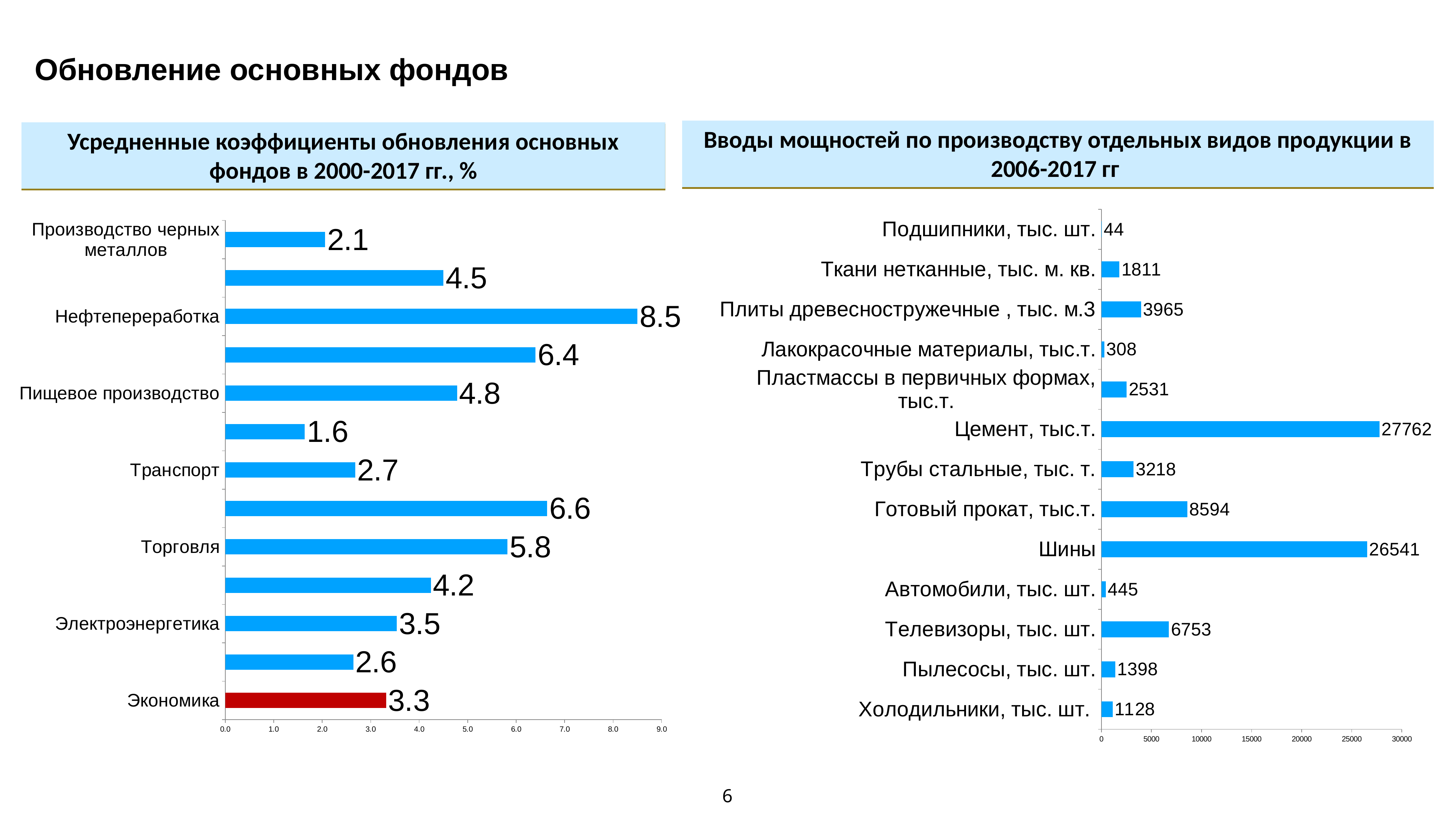
In the right chart (Вводы мощностей по производству отдельных видов продукции в 2006-2017 гг), which category has the highest value? Цемент, тыс.т. In the left chart (Усредненные коэффициенты обновления основных фондов в 2000-2017 гг., %), which labeled category has the highest value? Нефтепереработка In the left chart (Усредненные коэффициенты обновления основных фондов в 2000-2017 гг., %), what colour is the bar for Экономика? Red In the left chart (Усредненные коэффициенты обновления основных фондов в 2000-2017 гг., %), how many bars are plotted? 13 In the right chart (Вводы мощностей по производству отдельных видов продукции в 2006-2017 гг), which category has the lowest value? Подшипники, тыс. шт. In the right chart (Вводы мощностей по производству отдельных видов продукции в 2006-2017 гг), what is the difference between Шины and Готовый прокат, тыс.т.? 17947 In the left chart (Усредненные коэффициенты обновления основных фондов в 2000-2017 гг., %), what is the value for Нефтепереработка? 8.5 In the right chart (Вводы мощностей по производству отдельных видов продукции в 2006-2017 гг), what is the value for Цемент, тыс.т.? 27762 What type of chart is the right chart (Вводы мощностей по производству отдельных видов продукции в 2006-2017 гг)? Bar chart In the left chart (Усредненные коэффициенты обновления основных фондов в 2000-2017 гг., %), what is the value for Экономика? 3.3 In the left chart (Усредненные коэффициенты обновления основных фондов в 2000-2017 гг., %), what is the difference between Торговля and Транспорт? 3.1 In the left chart (Усредненные коэффициенты обновления основных фондов в 2000-2017 гг., %), which is larger: Пищевое производство or Электроэнергетика? Пищевое производство